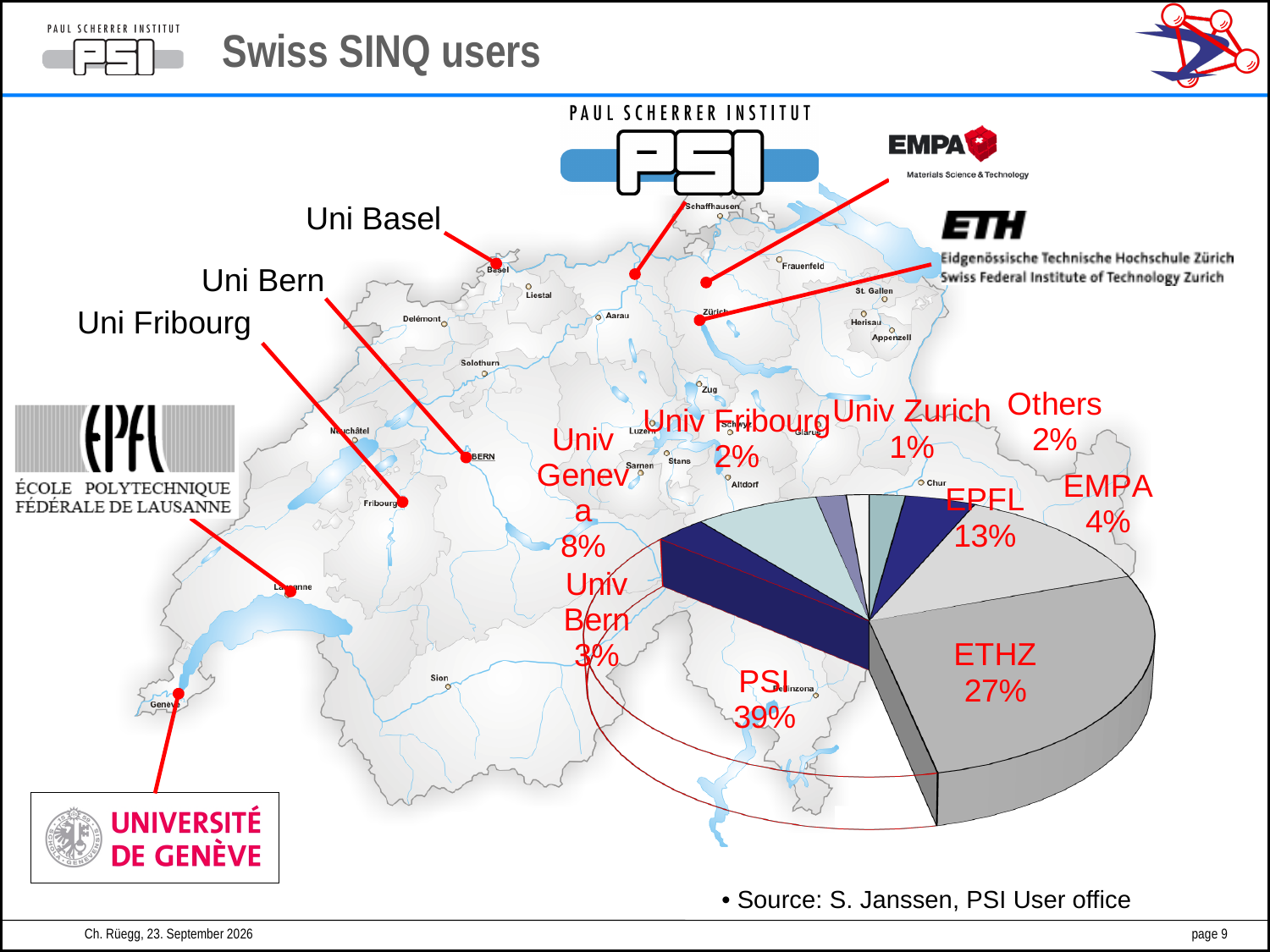
What share of Swiss SINQ users does PSI account for? 39% What is the difference in percentage points between the PSI share and the ETHZ share? 12 What is the combined share of Univ Bern and Univ Fribourg? 5% What share of Swiss SINQ users does EMPA account for? 4% Which has a larger share of Swiss SINQ users, EPFL or Univ Geneva? EPFL How many slices does the pie chart have? 9 What share of Swiss SINQ users does Univ Geneva account for? 8% Which institution has the largest share of Swiss SINQ users? PSI What share of Swiss SINQ users does EPFL account for? 13% What share of Swiss SINQ users does ETHZ account for? 27% What kind of chart is shown on the slide? pie chart Which institution has the smallest share of Swiss SINQ users? Univ Zurich